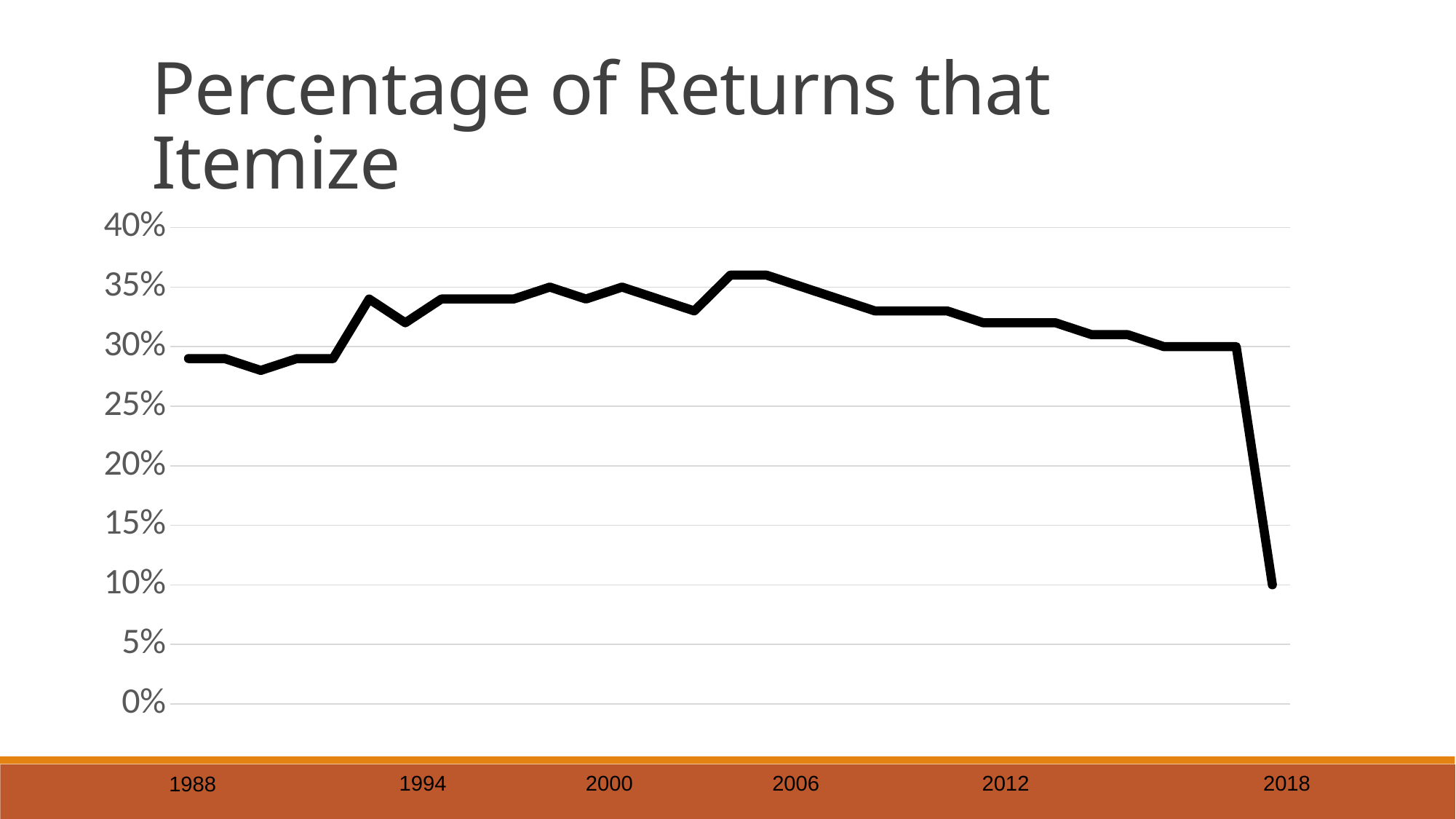
Do the values rise or fall between 1988 and 1994? rise Is the value for 2018 greater or less than 15%? less Is the value for 2012 greater or less than 30%? greater Which year has the lowest percentage of returns that itemize? 2018 Is the value for 1988 greater or less than 25%? greater Which year has the larger value, 1988 or 2018? 1988 What is the title of the chart? Percentage of Returns that Itemize Do the values rise or fall between 2006 and 2018? fall What kind of chart is shown on the slide? line chart What is the highest value shown on the y axis? 40% Which year has the larger value, 2006 or 2012? 2006